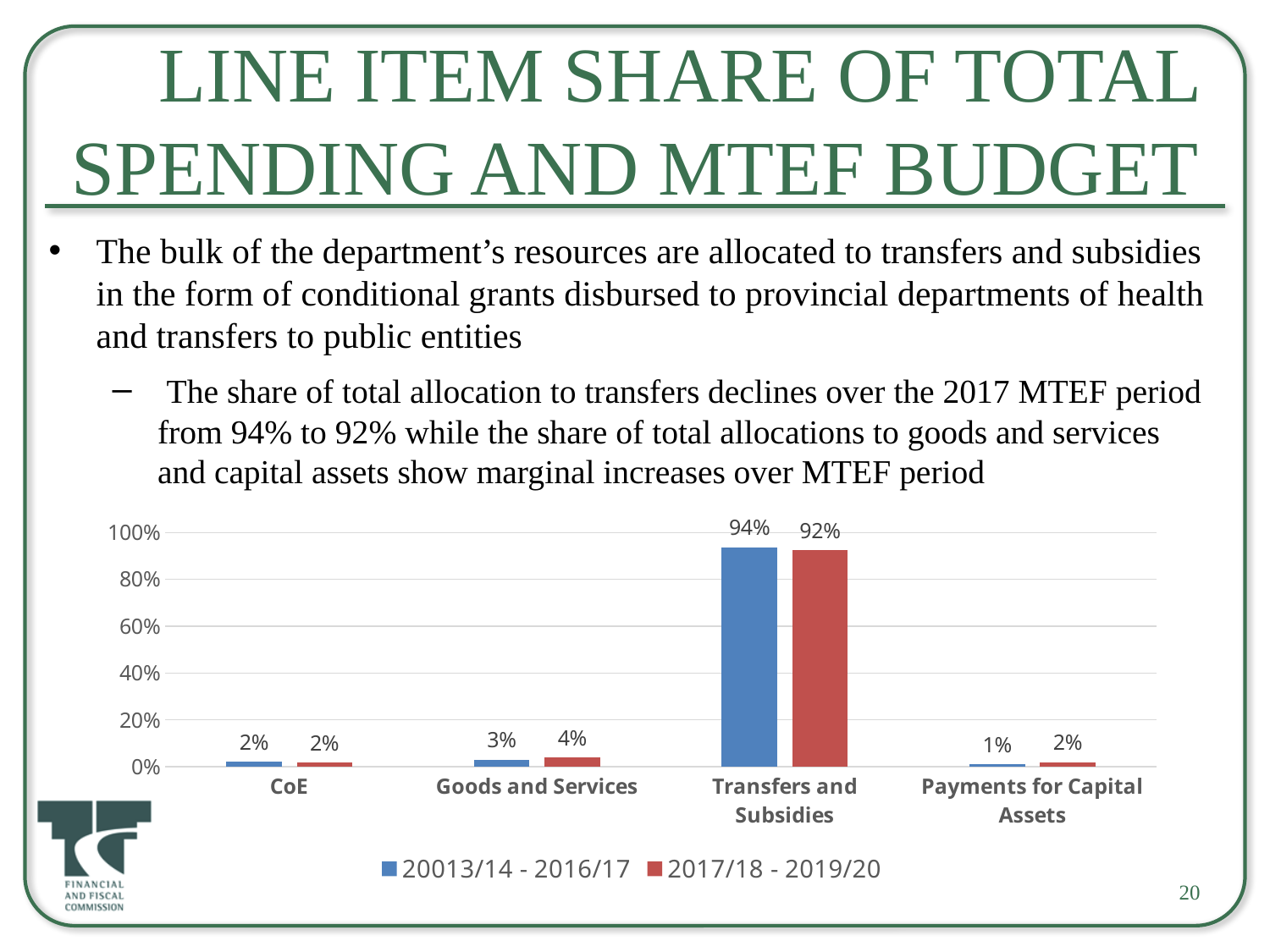
Is the value for Transfers and Subsidies in the 20013/14 - 2016/17 series greater or less than 80%? greater What is the value for CoE in the 2017/18 - 2019/20 series? 2% What is the value for Goods and Services in the 2017/18 - 2019/20 series? 4% How many series does the chart legend list? 2 Which category has the lowest value in the 20013/14 - 2016/17 series? Payments for Capital Assets Which category has the highest value in the 2017/18 - 2019/20 series? Transfers and Subsidies How many categories are shown on the x axis of the chart? 4 What is the difference between the 20013/14 - 2016/17 and 2017/18 - 2019/20 values for Transfers and Subsidies? 2% What is the value for Payments for Capital Assets in the 20013/14 - 2016/17 series? 1% Which is larger for Goods and Services: the 20013/14 - 2016/17 value or the 2017/18 - 2019/20 value? 2017/18 - 2019/20 What is the value for Transfers and Subsidies in the 20013/14 - 2016/17 series? 94% What kind of chart is shown on the slide? Bar chart